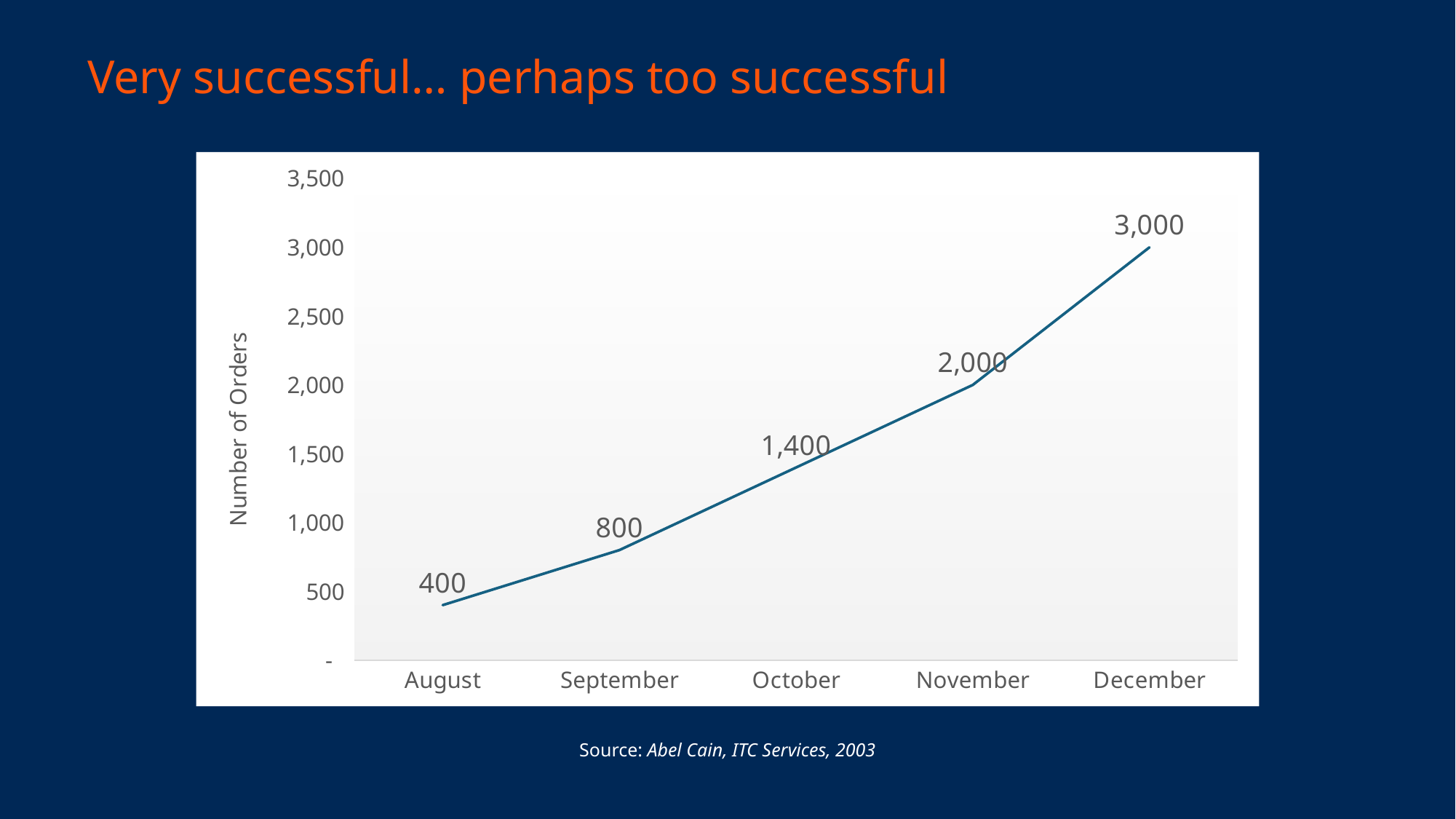
What is the number of orders in August? 400 What kind of chart is shown on the slide? Line chart What is the number of orders in October? 1,400 How many months are plotted on the chart? 5 Which month has the lowest number of orders? August Which month has the highest number of orders? December What is the number of orders in December? 3,000 Do the number of orders rise or fall from August to December? Rise Which month has more orders, September or November? November What is the difference in number of orders between December and November? 1,000 What is the label on the vertical axis of the chart? Number of Orders What is the difference in number of orders between October and September? 600